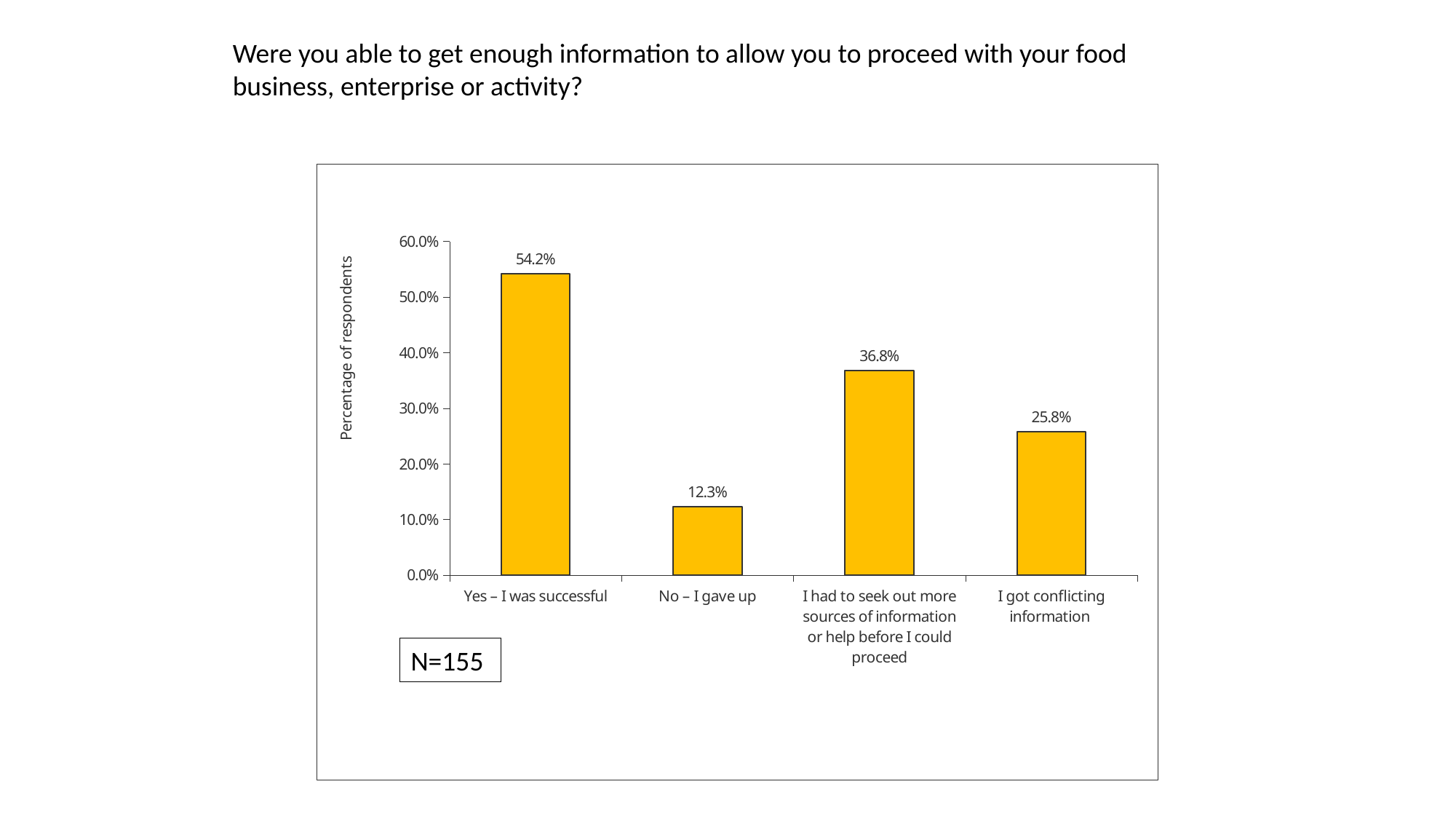
What kind of chart is shown on the slide? Bar chart Which is larger: the percentage for "I had to seek out more sources of information or help before I could proceed" or for "I got conflicting information"? I had to seek out more sources of information or help before I could proceed What percentage of respondents answered "Yes – I was successful"? 54.2% What percentage of respondents said they got conflicting information? 25.8% Which response category has the lowest percentage of respondents? No – I gave up What is the difference in percentage points between "Yes – I was successful" and "No – I gave up"? 41.9 percentage points What percentage of respondents said they had to seek out more sources of information or help before they could proceed? 36.8% How many response categories are shown in the chart? 4 What is the sample size (N) shown on the slide? N=155 Which response category has the highest percentage of respondents? Yes – I was successful What percentage of respondents answered "No – I gave up"? 12.3% Is the value for "I got conflicting information" greater or less than 30.0%? less